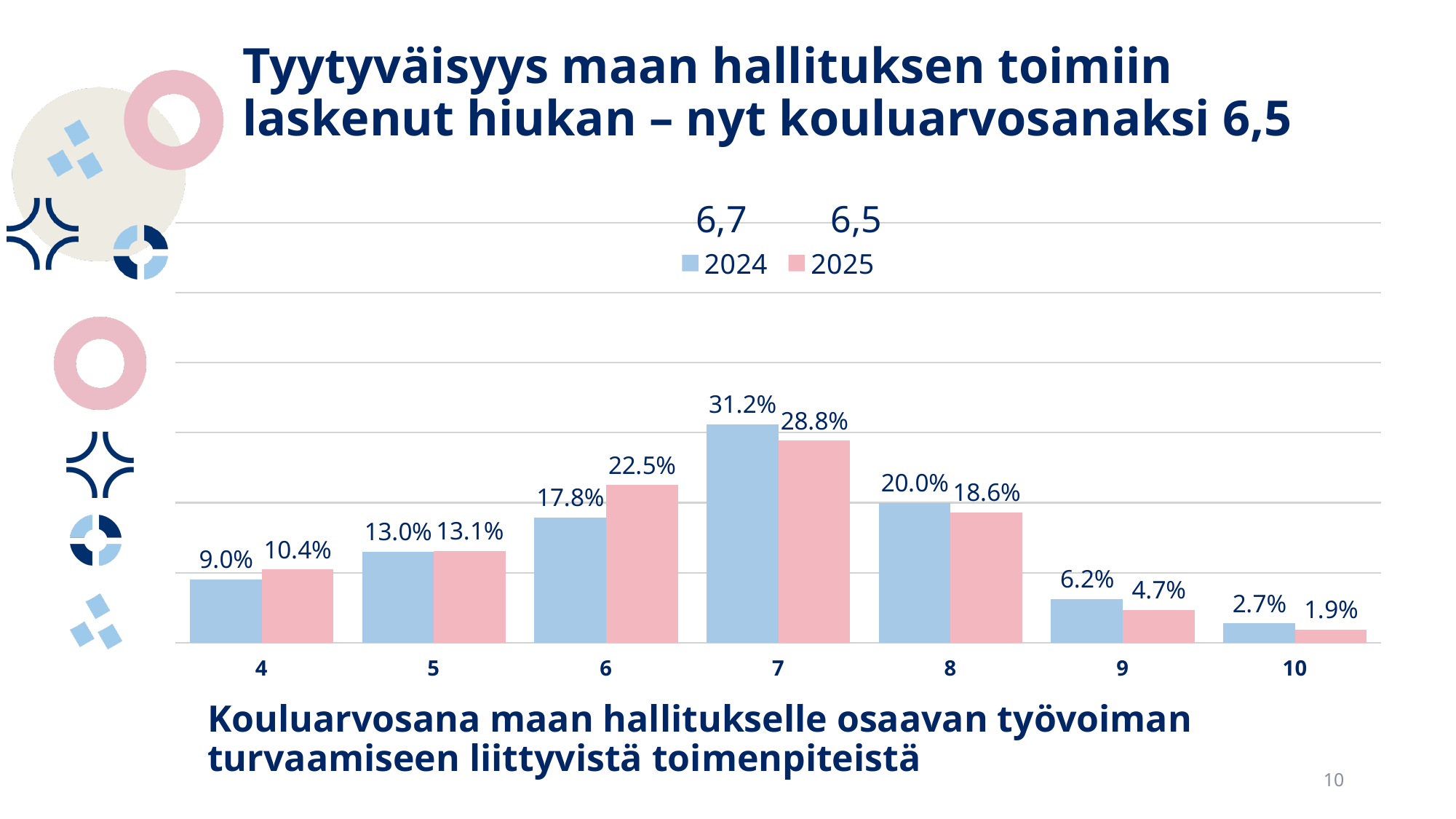
Which grade has the highest value in the 2025 series? 7 Which is larger for grade 8: the 2024 value or the 2025 value? 2024 Which is larger for grade 4: the 2024 value or the 2025 value? 2025 Which grade has the lowest value in the 2024 series? 10 What is the difference between the 2024 and 2025 values for grade 9? 1.5% What is the value for grade 10 in the 2025 series? 1.9% How many grade categories are shown on the x axis? 7 What is the value for grade 6 in the 2025 series? 22.5% How many series does the legend list? 2 What is the value for grade 7 in the 2024 series? 31.2% What are the two series named in the legend? 2024 and 2025 What kind of chart is shown on the slide? bar chart